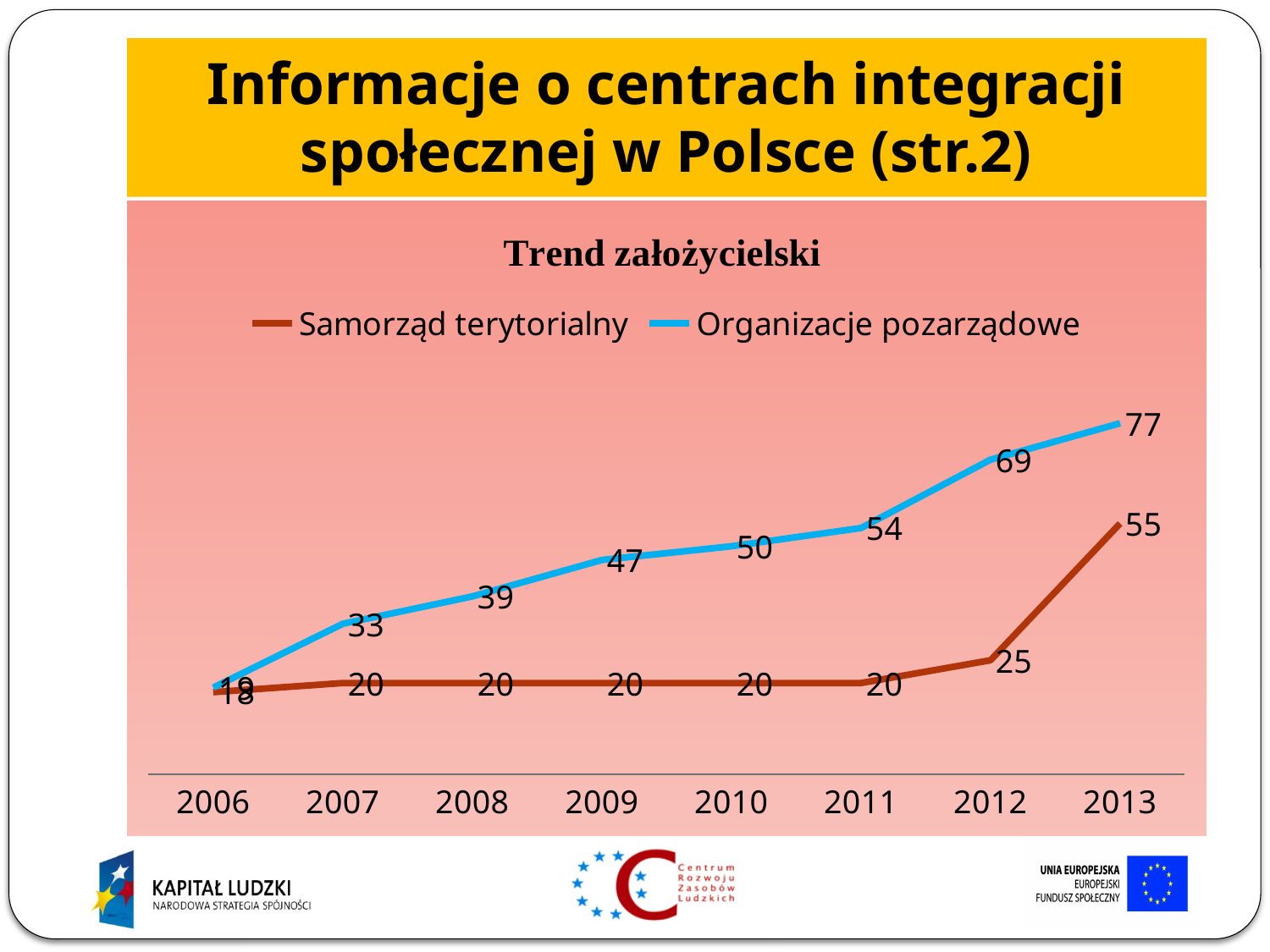
What is the value for Organizacje pozarządowe in 2009? 47 What is the chart's title? Trend założycielski In which year is the value for Organizacje pozarządowe highest? 2013 How many series does the legend list? 2 In which year is the value for Samorząd terytorialny highest? 2013 What is the value for Samorząd terytorialny in 2012? 25 What is the value for Organizacje pozarządowe in 2013? 77 Which series has the larger value in 2012, Samorząd terytorialny or Organizacje pozarządowe? Organizacje pozarządowe What type of chart is shown on the slide? line chart Do the values for Organizacje pozarządowe rise or fall from 2006 to 2013? rise How many years are shown on the x axis? 8 What is the difference between Organizacje pozarządowe and Samorząd terytorialny in 2013? 22